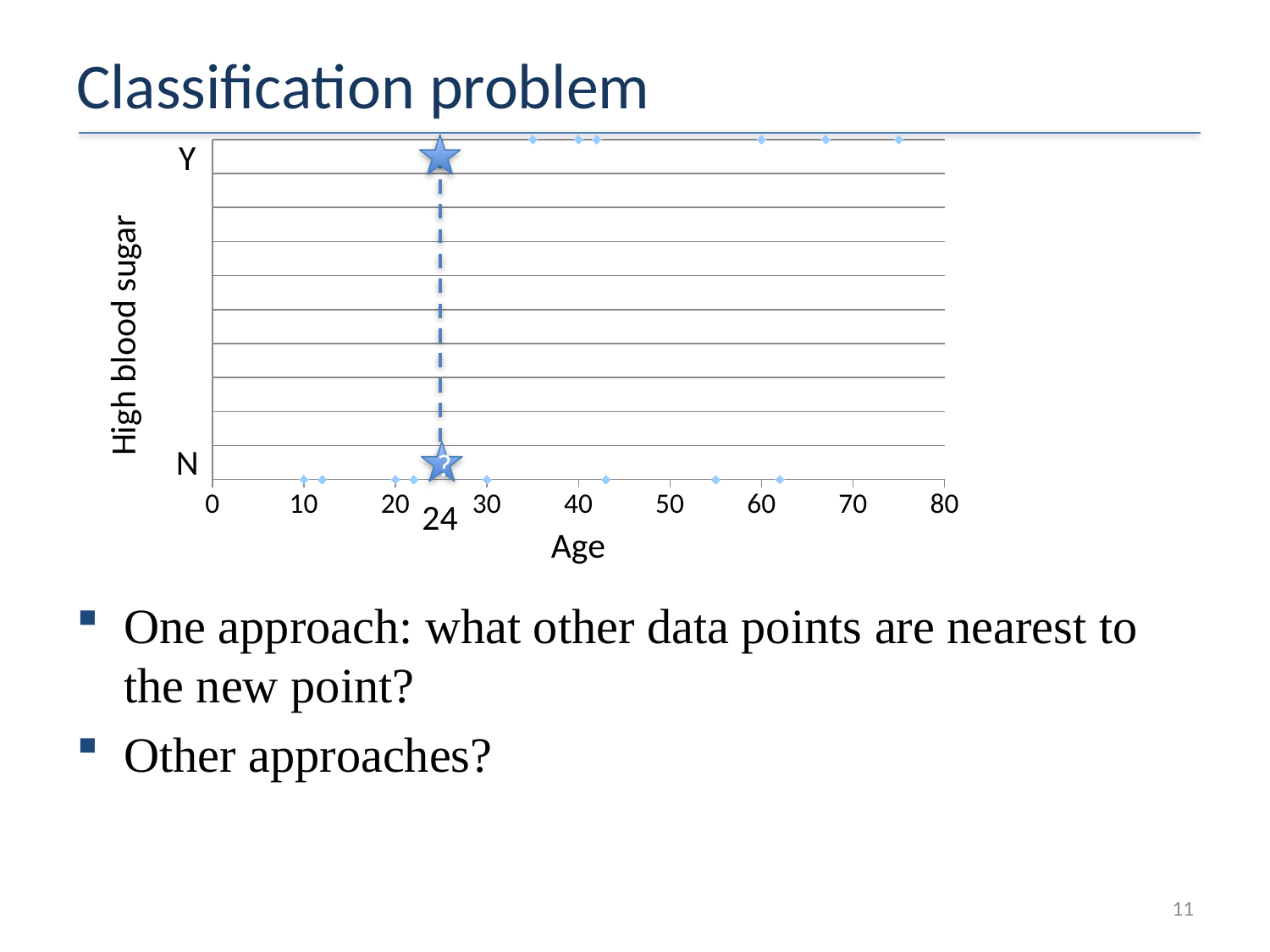
Which row, Y or N, contains the data point with the smallest age? N Is the age of the leftmost data point greater or less than 20? less What is the highest value shown on the Age axis? 80 What is the title of the y axis of the chart? High blood sugar What is the title of the x axis of the chart? Age Is the age of the new point marked with a star greater or less than 30? less What kind of chart is shown on the slide? Scatter chart How many data points are plotted in the Y (high blood sugar) row? 6 Which row, Y or N, contains the data point with the largest age? Y Is the age of the leftmost data point in the Y (high blood sugar) row greater or less than 30? greater What age is the new point marked with a star and a question mark? 24